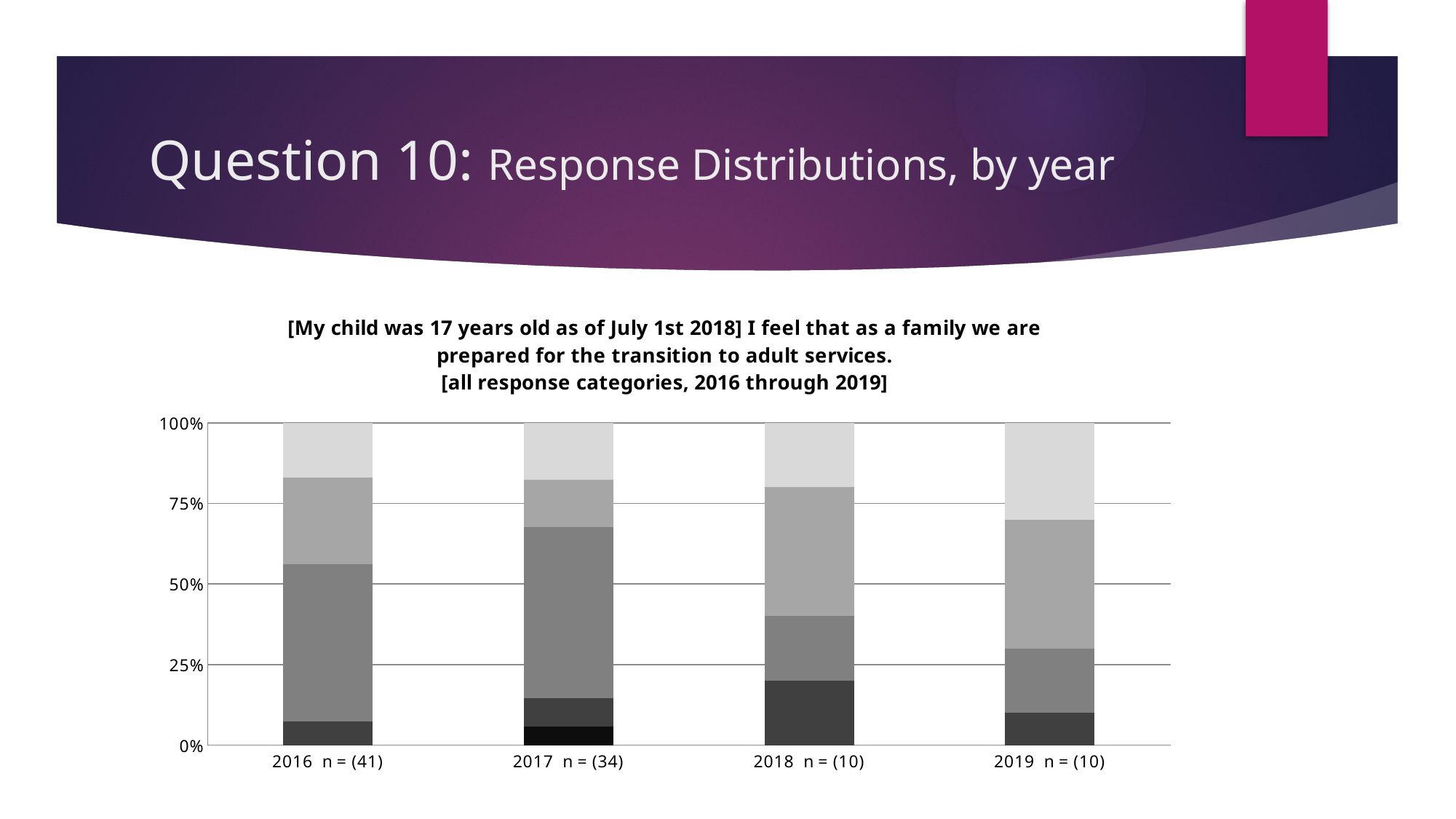
Is the top of the second-from-top (light gray) segment of the 2019 bar greater or less than 75%? less How many years (bars) are shown on the x axis of the chart? 4 Which bar has the larger darkest (bottom) segment, 2016 or 2018? 2018 Is the top of the darkest (bottom) segment of the 2018 bar greater or less than 25%? less Which year has the largest darkest (bottom) segment in the chart? 2018 Is the top of the second-from-top (light gray) segment of the 2018 bar greater or less than 75%? greater What is the sample size (n) shown for 2016 on the x axis? 41 What range of years does the chart title say the response categories cover? 2016 through 2019 What is the total height of each stacked bar in the chart? 100% Which year has the largest lightest (top) segment in the chart? 2019 What kind of chart is shown on the slide? Stacked bar chart